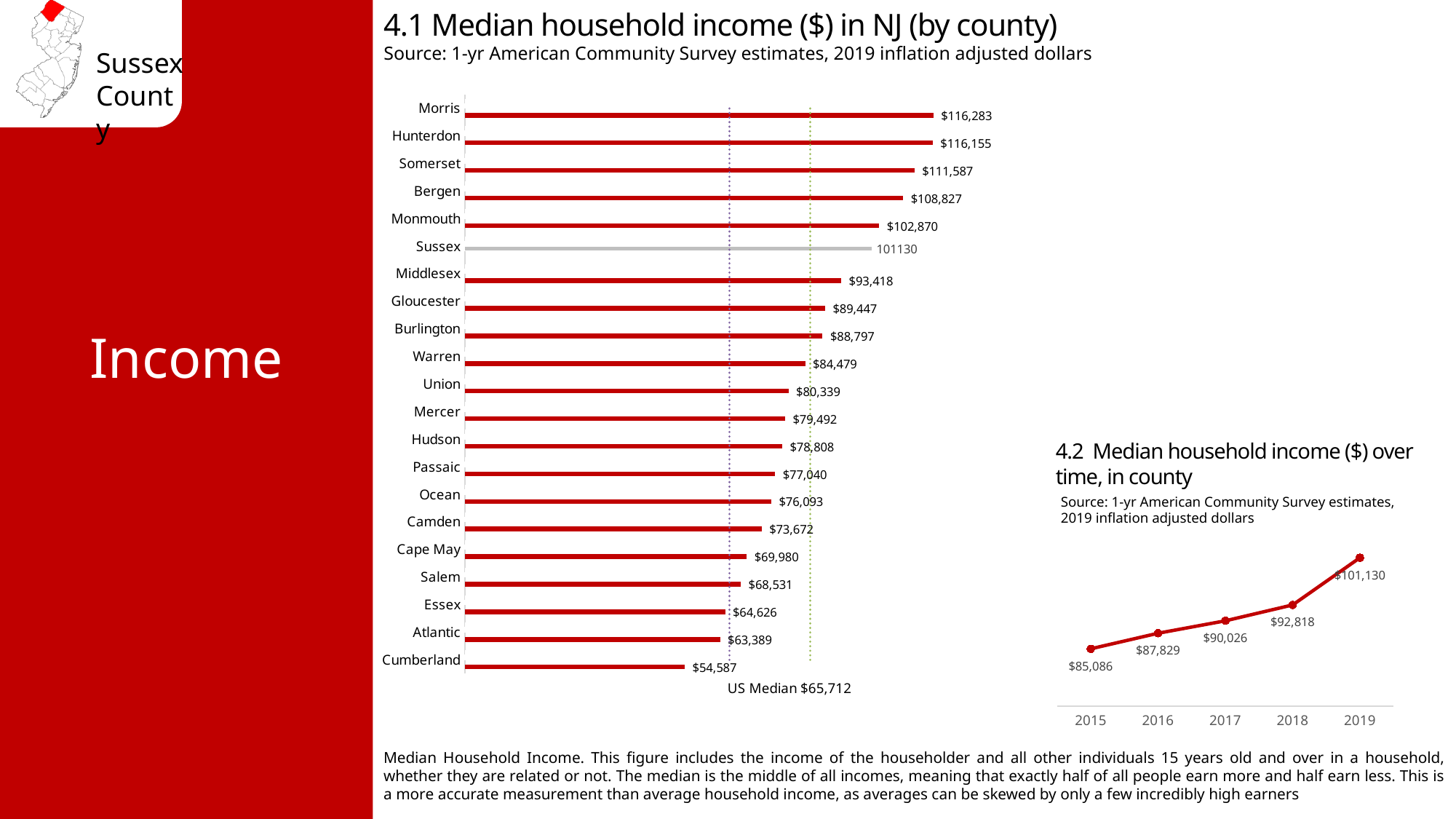
In chart 4.1 (Median household income in NJ by county), which has a higher median household income, Bergen or Monmouth? Bergen In chart 4.1 (Median household income in NJ by county), how many counties are plotted? 21 In chart 4.2 (Median household income over time, in county), how many years are plotted? 5 In chart 4.2 (Median household income over time, in county), what is the difference between the 2019 and 2015 values? $16,044 In chart 4.1 (Median household income in NJ by county), what is the difference between the values for Morris and Hunterdon? $128 In chart 4.1 (Median household income in NJ by county), which county has the lowest median household income? Cumberland In chart 4.1 (Median household income in NJ by county), what is the median household income for Morris? $116,283 In chart 4.2 (Median household income over time, in county), what is the value for 2017? $90,026 In chart 4.2 (Median household income over time, in county), do the values rise or fall from 2015 to 2019? Rise In chart 4.1 (Median household income in NJ by county), which county has the highest median household income? Morris What kind of chart is chart 4.1 (Median household income in NJ by county)? Bar chart In chart 4.1 (Median household income in NJ by county), what is the value shown for Sussex? 101130